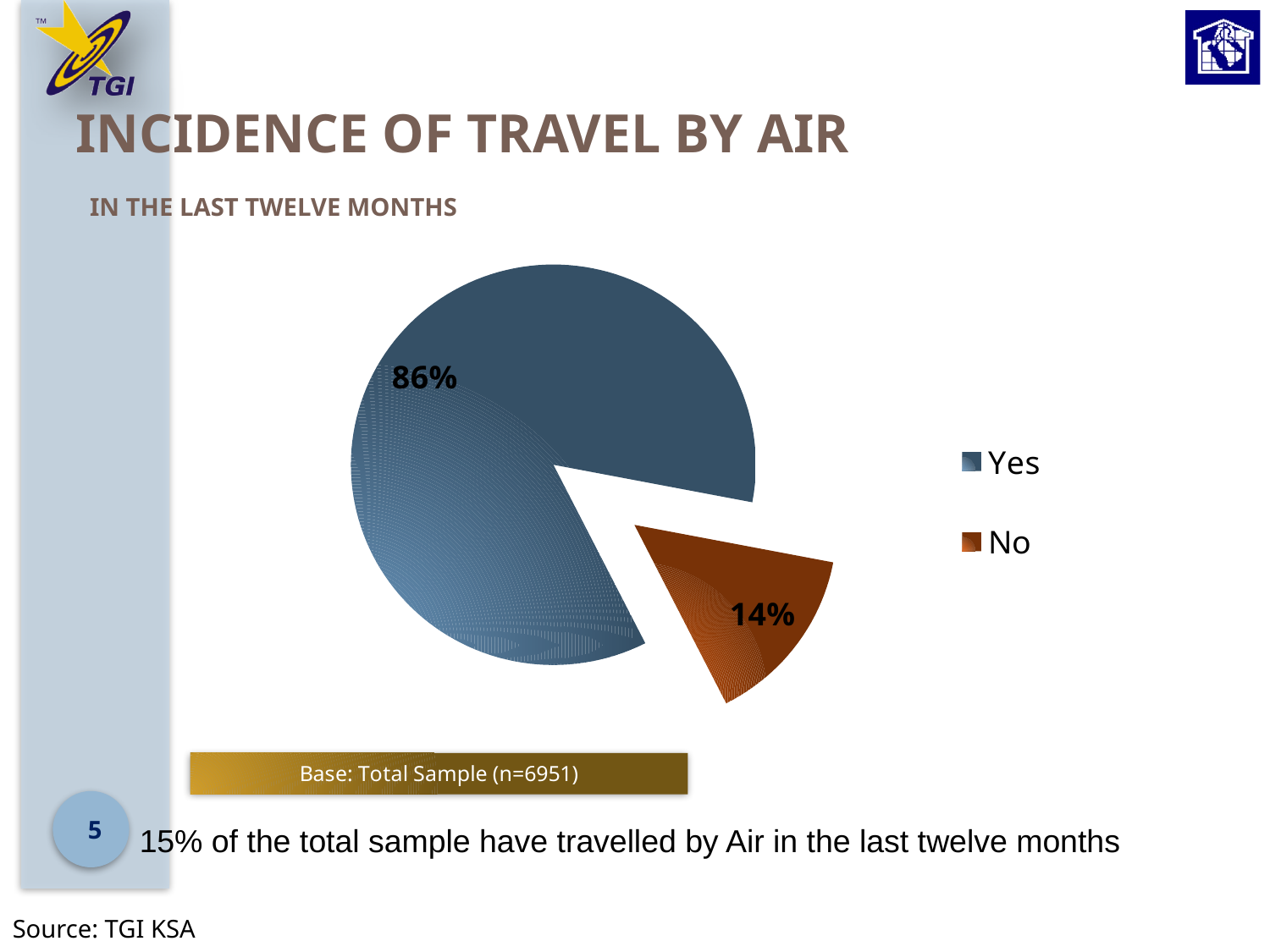
How many entries does the legend list? 2 Which slice of the pie is the smallest? No What is the difference in percentage points between the "Yes" and "No" slices? 72 What percentage of the pie is labelled "No"? 14% Which slice of the pie is the largest? Yes What kind of chart is shown on the slide? pie chart How many slices does the pie chart have? 2 What is the base sample size stated below the chart? n=6951 What colour is the "No" slice in the pie chart? orange-brown What share of the pie does the "No" slice represent? 14% What percentage of the pie is labelled "Yes"? 86% Which is larger, the "Yes" slice or the "No" slice? Yes